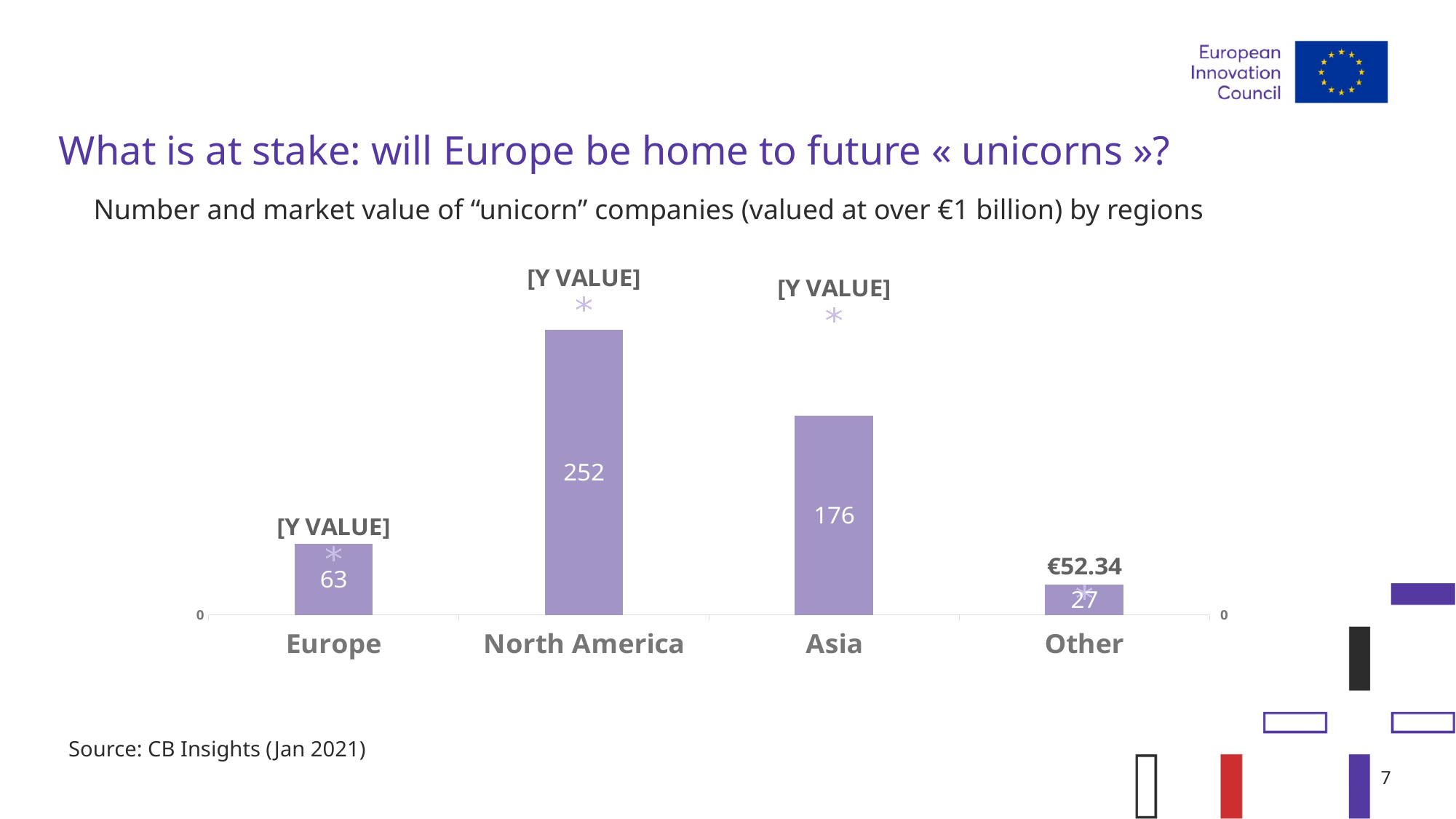
What market value label is printed above the Other bar? €52.34 Which region has the lowest number of unicorn companies? Other How many regions are shown on the x axis of the chart? 4 What is the difference between the number of unicorns in North America and Asia? 76 What is the number of unicorn companies shown for Europe? 63 Which region has more unicorn companies, Europe or Asia? Asia Which region has the highest number of unicorn companies? North America What is the number of unicorn companies shown for North America? 252 What is the difference between the number of unicorns in Asia and Europe? 113 What is the number of unicorn companies shown for Asia? 176 What kind of chart is used to show the number of unicorn companies by region? Bar chart What is the number of unicorn companies shown for Other? 27